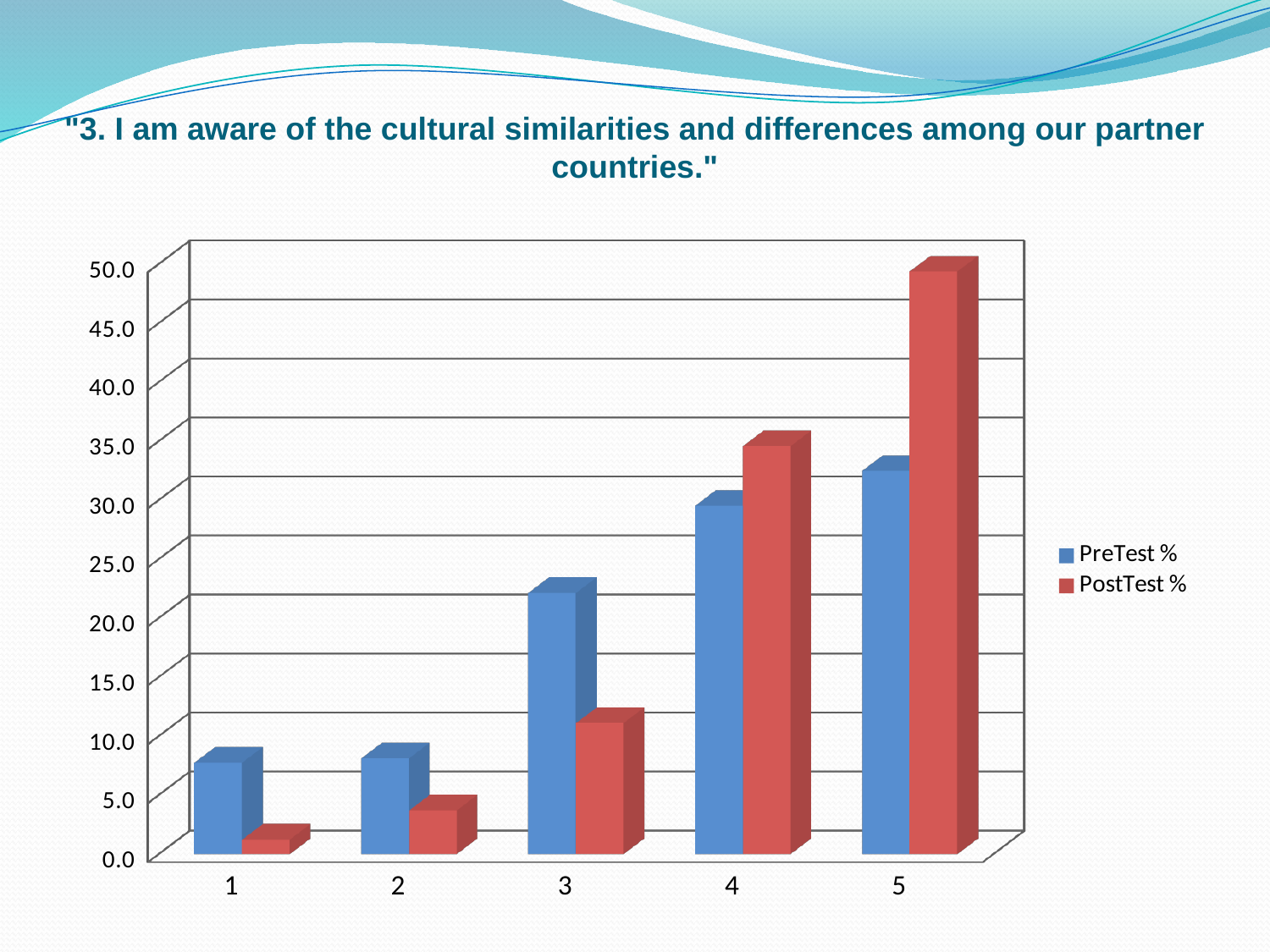
Is the PostTest % value for category 4 greater or less than 30? greater For category 5, which is larger, PreTest % or PostTest %? PostTest % How many series does the legend list? 2 Which category has the lowest PostTest % value? 1 Which category has the highest PreTest % value? 5 Is the PreTest % value for category 4 greater or less than 25? greater What kind of chart is shown on the slide? bar chart For category 3, which is larger, PreTest % or PostTest %? PreTest % How many categories are shown on the x axis? 5 Do the PostTest % values rise or fall from category 1 to category 5? rise Which category has the highest PostTest % value? 5 Is the PostTest % value for category 1 greater or less than 5? less